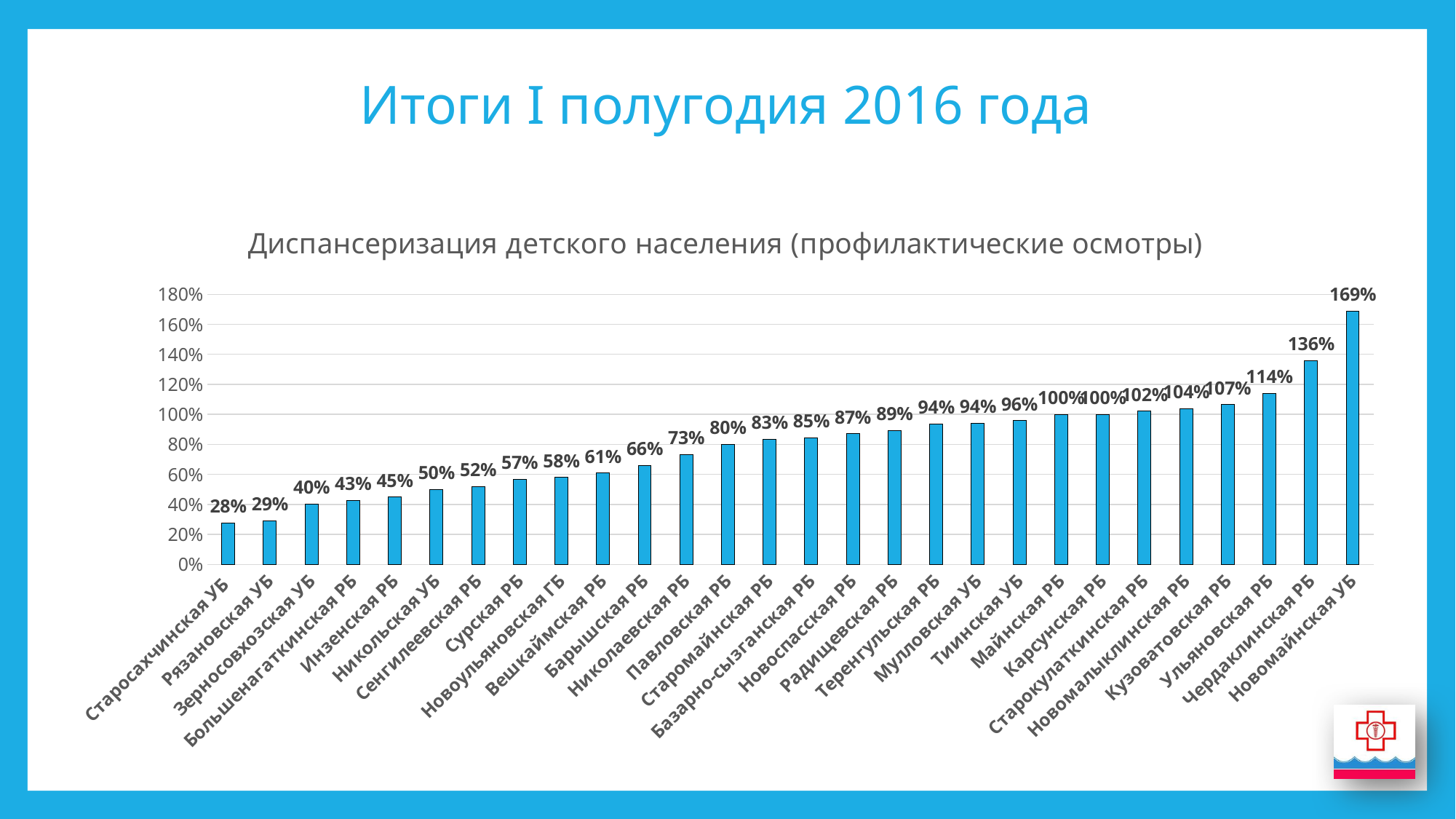
What is the value for Николаевская РБ? 73% Do the values rise or fall from left to right along the x axis? rise What is the difference between the values for Новомайнская УБ and Чердаклинская РБ? 33% Which category has the lowest value? Старосахчинская УБ What is the value for Новомайнская УБ? 169% Is the value for Ульяновская РБ greater or less than 100%? greater Which category has the highest value? Новомайнская УБ What kind of chart is shown on the slide? bar chart How many categories are shown in the chart? 28 What is the value for Зерносовхозская УБ? 40% Which is larger, the value for Павловская РБ or the value for Барышская РБ? Павловская РБ What is the title of the chart? Диспансеризация детского населения (профилактические осмотры)